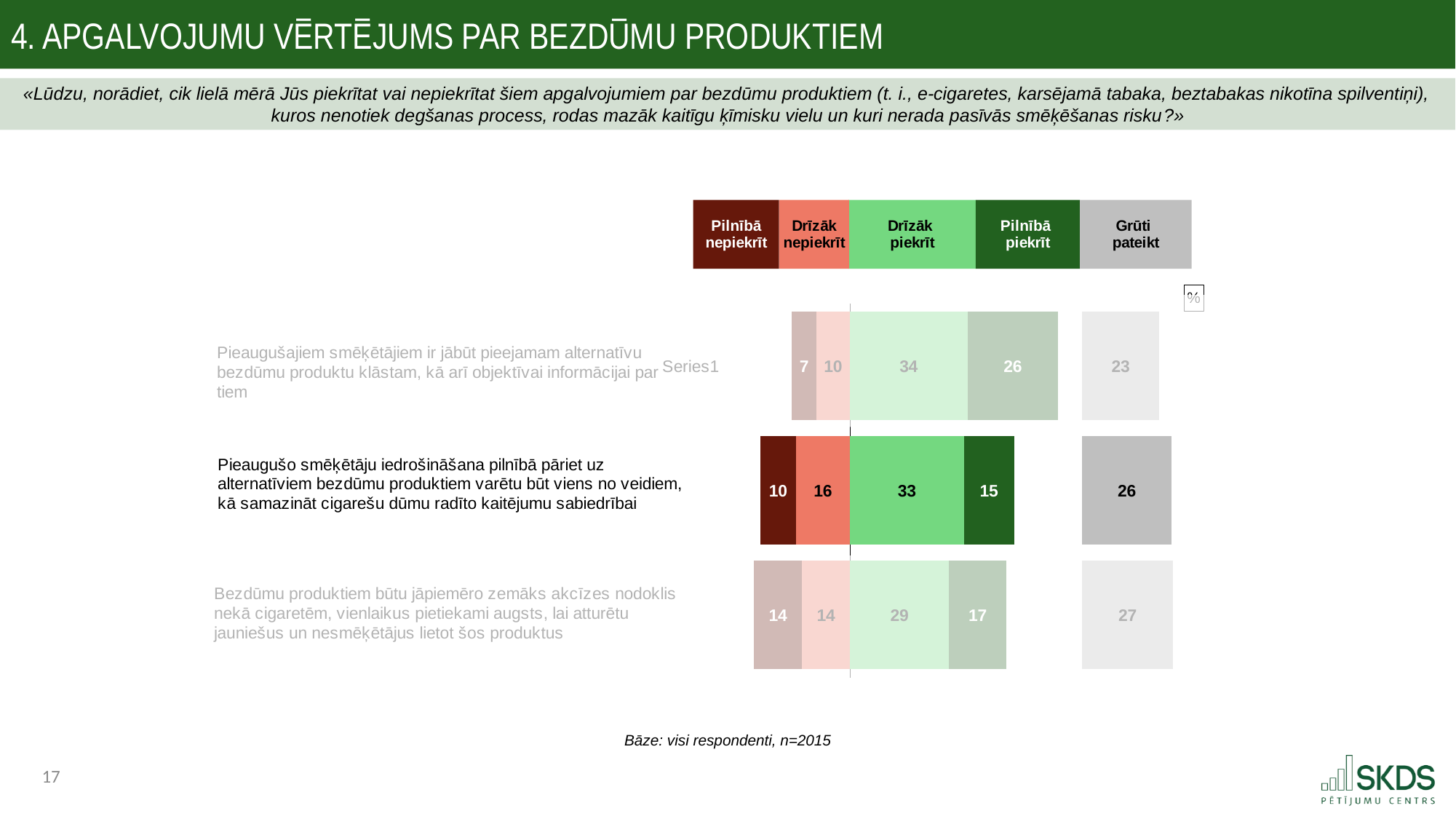
Which statement has the highest "Drīzāk piekrīt" value? Pieaugušajiem smēķētājiem ir jābūt pieejamam alternatīvu bezdūmu produktu klāstam, kā arī objektīvai informācijai par tiem Which is larger: the "Pilnībā piekrīt" value for the statement about a lower excise tax, or the "Pilnībā piekrīt" value for the statement about encouraging adult smokers to switch? The statement about a lower excise tax (17) What is the "Grūti pateikt" value for the statement "Bezdūmu produktiem būtu jāpiemēro zemāks akcīzes nodoklis nekā cigaretēm..."? 27 Which statement has the lowest "Pilnībā nepiekrīt" value? Pieaugušajiem smēķētājiem ir jābūt pieejamam alternatīvu bezdūmu produktu klāstam, kā arī objektīvai informācijai par tiem What percentage of respondents answered "Drīzāk piekrīt" for the statement "Pieaugušo smēķētāju iedrošināšana pilnībā pāriet uz alternatīviem bezdūmu produktiem..."? 33 What is the difference between the "Drīzāk nepiekrīt" values for the statement about encouraging adult smokers to switch (16) and the statement about adult smokers having access to alternative products (10)? 6 What is the "Pilnībā piekrīt" value for the statement "Pieaugušajiem smēķētājiem ir jābūt pieejamam alternatīvu bezdūmu produktu klāstam..."? 26 How many response categories does the legend list? 5 What type of chart is shown on the slide? Stacked bar chart How many statements are shown in the chart? 3 What is the combined total of "Drīzāk piekrīt" and "Pilnībā piekrīt" for the statement "Pieaugušo smēķētāju iedrošināšana pilnībā pāriet uz alternatīviem bezdūmu produktiem..."? 48 What is the "Pilnībā nepiekrīt" value for the statement "Bezdūmu produktiem būtu jāpiemēro zemāks akcīzes nodoklis nekā cigaretēm..."? 14